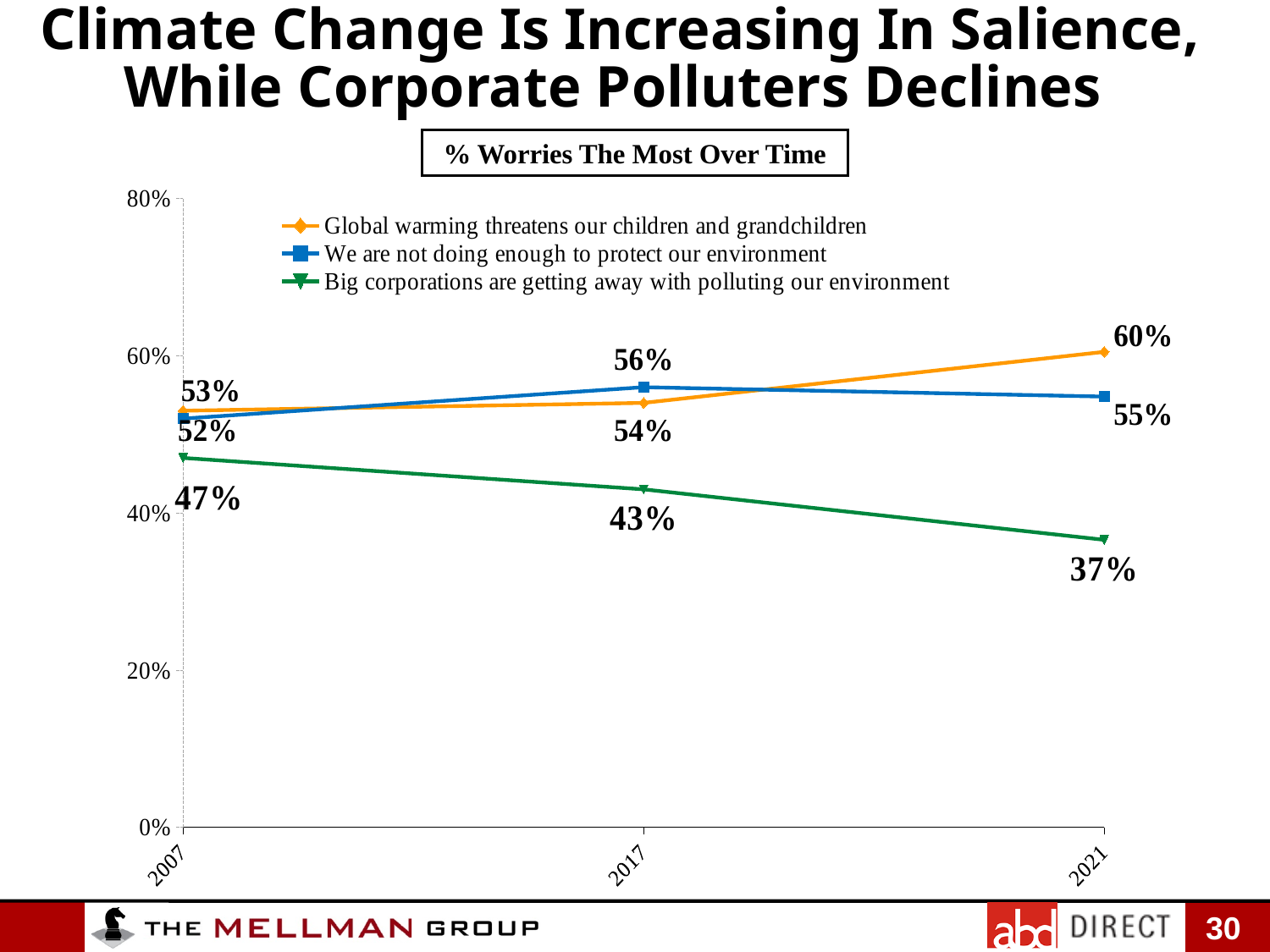
What is the title shown in the box above the chart? % Worries The Most Over Time What is the value for 'We are not doing enough to protect our environment' in 2017? 56% In 2017, which is larger: 'We are not doing enough to protect our environment' or 'Global warming threatens our children and grandchildren'? We are not doing enough to protect our environment What kind of chart is shown on the slide? line chart By how many percentage points did 'Big corporations are getting away with polluting our environment' fall from 2007 to 2021? 10 percentage points What is the value for 'Big corporations are getting away with polluting our environment' in 2021? 37% What is the value for 'Big corporations are getting away with polluting our environment' in 2007? 47% Which series has the highest value in 2021? Global warming threatens our children and grandchildren How many series does the legend list? 3 Does the 'Big corporations are getting away with polluting our environment' line rise or fall from 2007 to 2021? fall What is the value for 'Global warming threatens our children and grandchildren' in 2021? 60% How many years are plotted along the x axis? 3